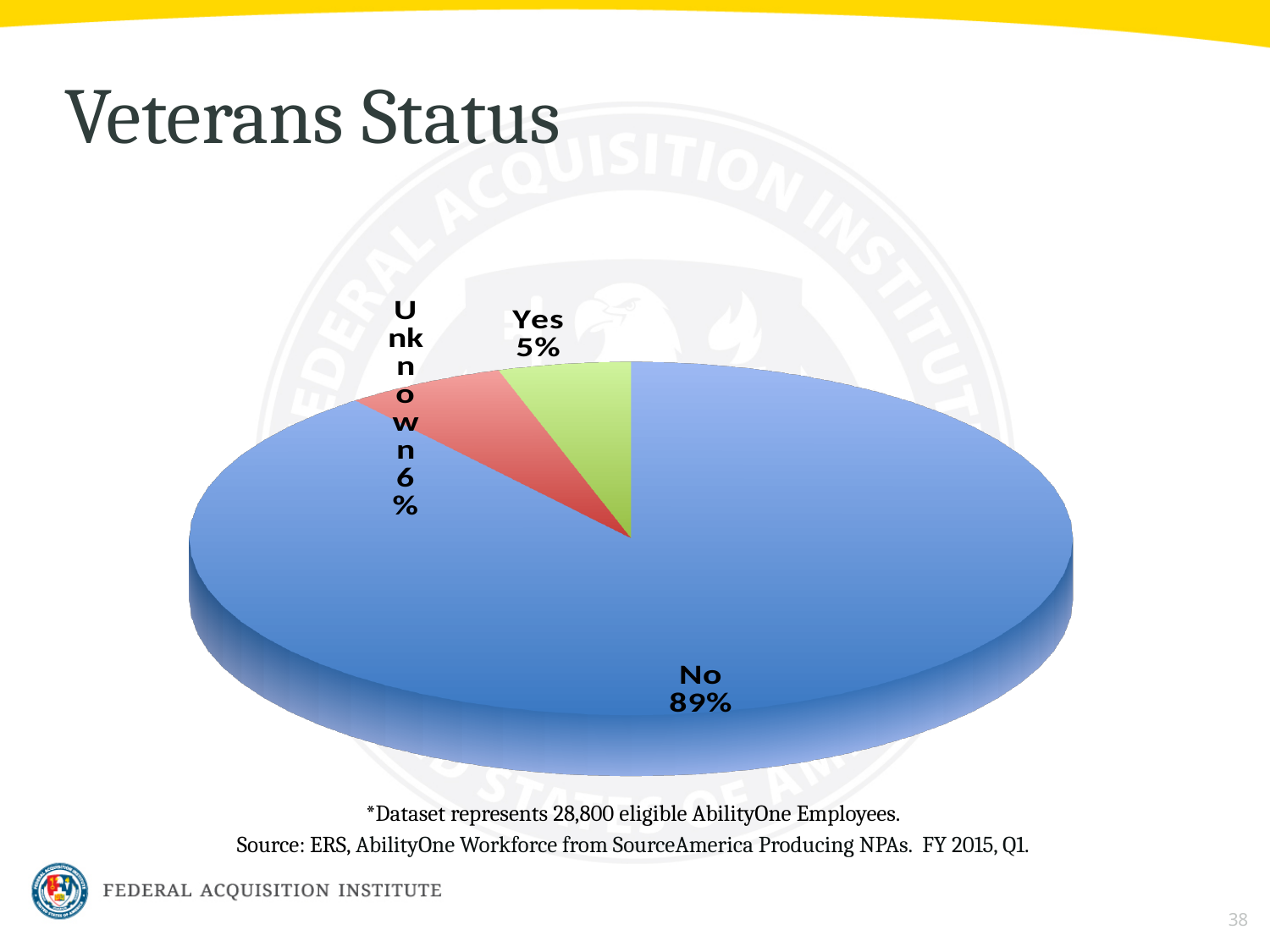
Which is larger, the "No" slice or the "Unknown" slice? No Which category has the smallest slice of the pie? Yes What is the title of the slide containing the chart? Veterans Status Which category has the largest slice of the pie? No What kind of chart is shown on the slide? Pie chart What share of the pie is labelled "Yes"? 5% What share of the pie is labelled "No"? 89% What share of the pie is labelled "Unknown"? 6% What colour is the "Yes" slice of the pie? Green What is the difference in percentage points between the "Unknown" slice and the "Yes" slice? 1 What is the difference in percentage points between the "No" slice and the "Yes" slice? 84 How many slices does the pie chart have? 3